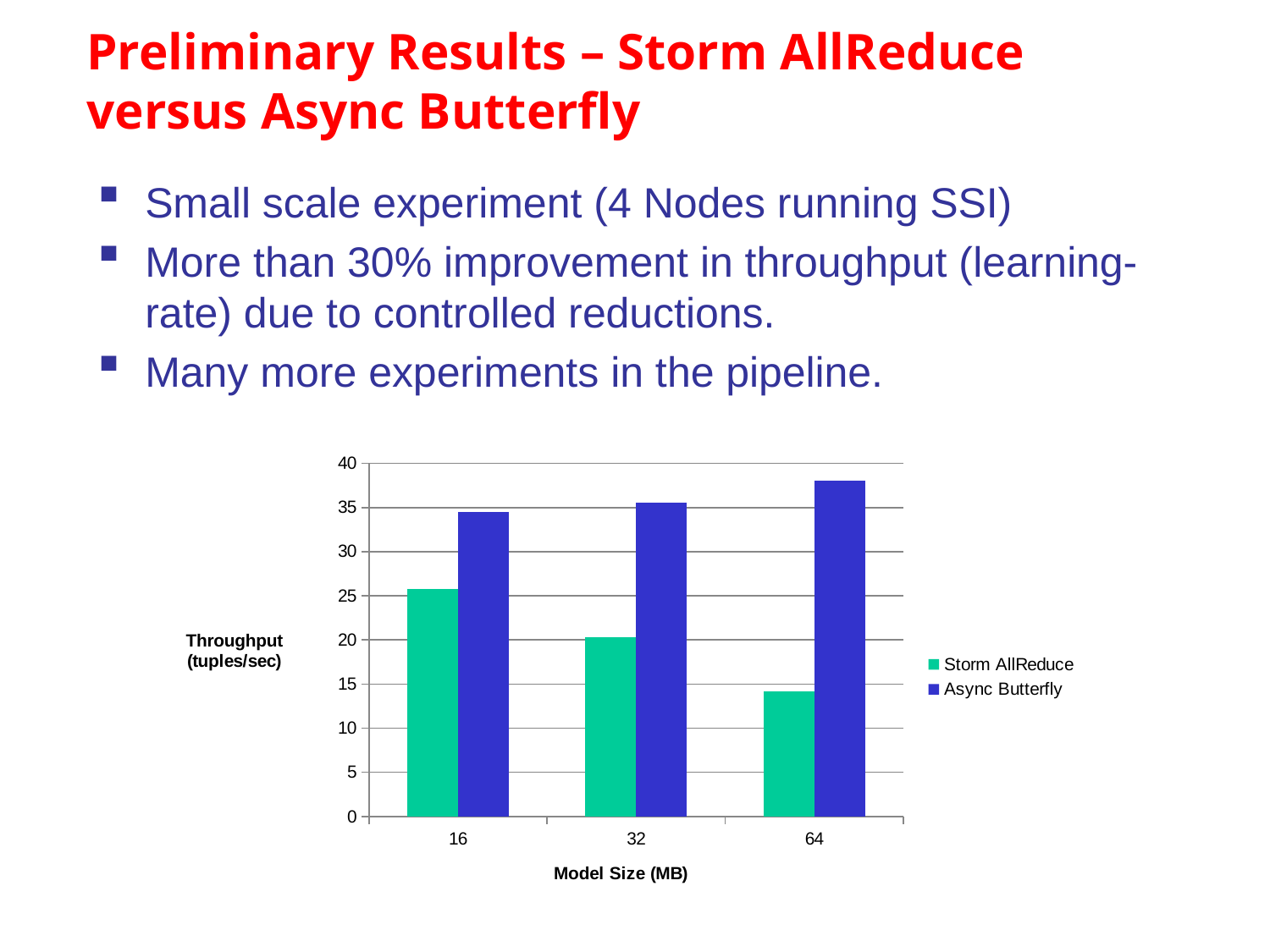
How many series does the legend list? 2 Is the Async Butterfly throughput for model size 64 greater or less than 35? greater Which model size has the highest Storm AllReduce throughput? 16 What kind of chart is shown on the slide? bar chart How many model size categories are shown on the x axis? 3 Is the Storm AllReduce throughput for model size 16 greater or less than 25? greater At model size 32, which series has the higher throughput, Storm AllReduce or Async Butterfly? Async Butterfly Which model size has the highest Async Butterfly throughput? 64 Is the Storm AllReduce throughput for model size 64 greater or less than 15? less Does the Storm AllReduce throughput rise or fall as model size increases from 16 to 64? fall Which model size has the lowest Storm AllReduce throughput? 64 What is the label of the y axis? Throughput (tuples/sec)